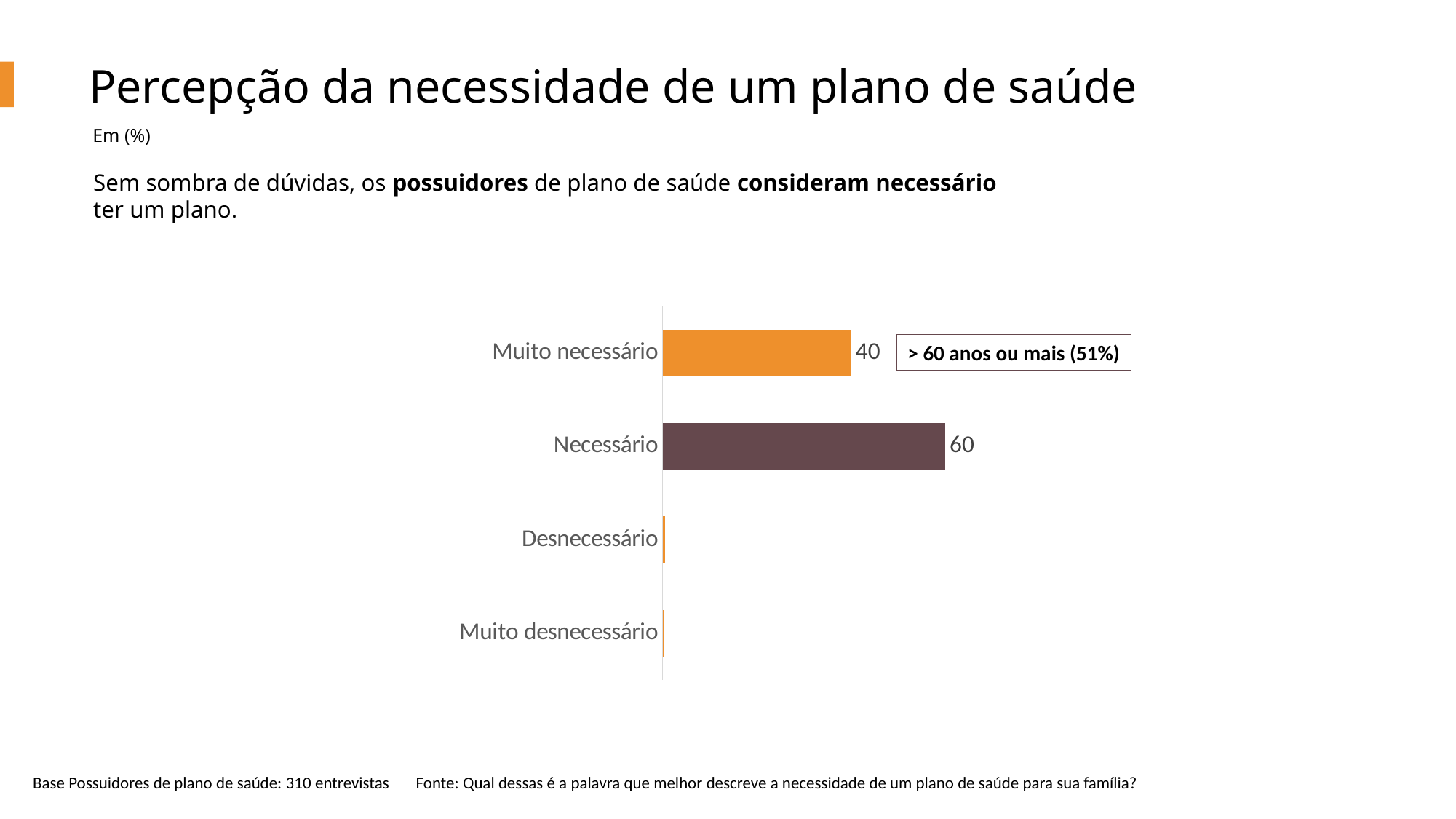
What kind of chart is shown on the slide? Bar chart Which category has the highest value? Necessário Which is larger, the value for Muito necessário or the value for Necessário? Necessário What percentage is shown in the callout box next to the Muito necessário bar? 51% What is the value for Necessário? 60 How many categories are shown on the chart? 4 What is the difference between the values for Necessário and Muito necessário? 20 What is the total of the values printed for Muito necessário and Necessário? 100 Which is larger, the value for Necessário or the value for Desnecessário? Necessário What is the title of the slide containing the chart? Percepção da necessidade de um plano de saúde What is the value for Muito necessário? 40 What is the label of the bottom category on the chart? Muito desnecessário